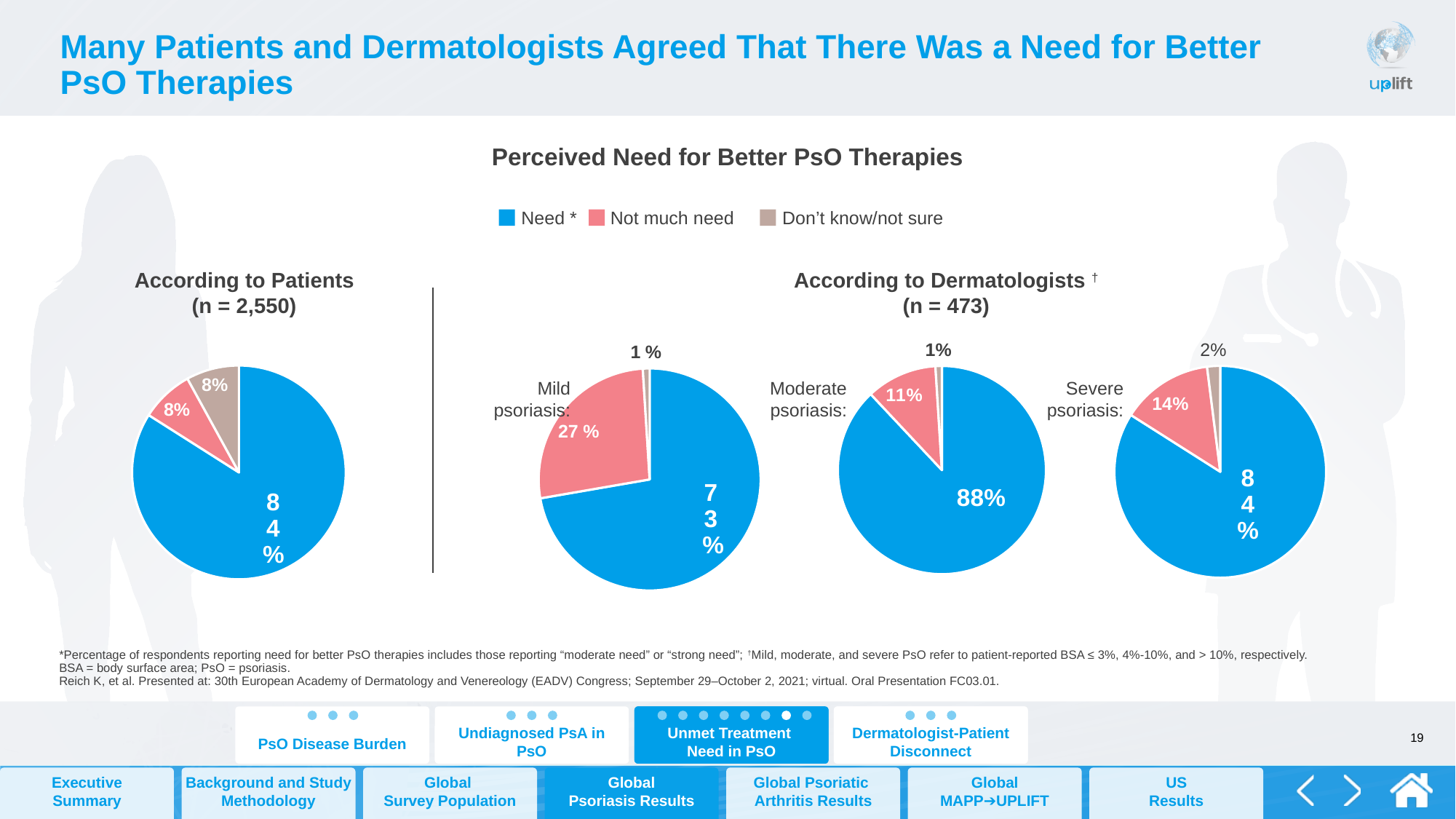
What is the difference between the 'Need' percentage in the 'Moderate psoriasis' pie chart and the 'Need' percentage in the 'Mild psoriasis' pie chart? 15% In the 'According to Patients' pie chart, what percentage of patients reported a need for better PsO therapies? 84% Which is larger: the 'Not much need' percentage in the 'Severe psoriasis' pie chart or in the 'Moderate psoriasis' pie chart? Severe psoriasis What type of chart is used to show the 'Perceived Need for Better PsO Therapies' data? Pie chart In the 'Severe psoriasis' pie chart under 'According to Dermatologists', what percentage is shown for 'Not much need'? 14% In the 'Mild psoriasis' pie chart under 'According to Dermatologists', what percentage is shown for 'Need'? 73 % Among the three 'According to Dermatologists' pie charts, which psoriasis severity has the highest percentage for 'Need'? Moderate psoriasis In the 'Mild psoriasis' pie chart under 'According to Dermatologists', what percentage is shown for 'Not much need'? 27 % How many series does the legend list for the 'Perceived Need for Better PsO Therapies' charts? 3 Among the three 'According to Dermatologists' pie charts, which psoriasis severity has the lowest percentage for 'Need'? Mild psoriasis In the 'Moderate psoriasis' pie chart under 'According to Dermatologists', what percentage is shown for 'Need'? 88% In the 'Severe psoriasis' pie chart under 'According to Dermatologists', what percentage is shown for 'Don't know/not sure'? 2%